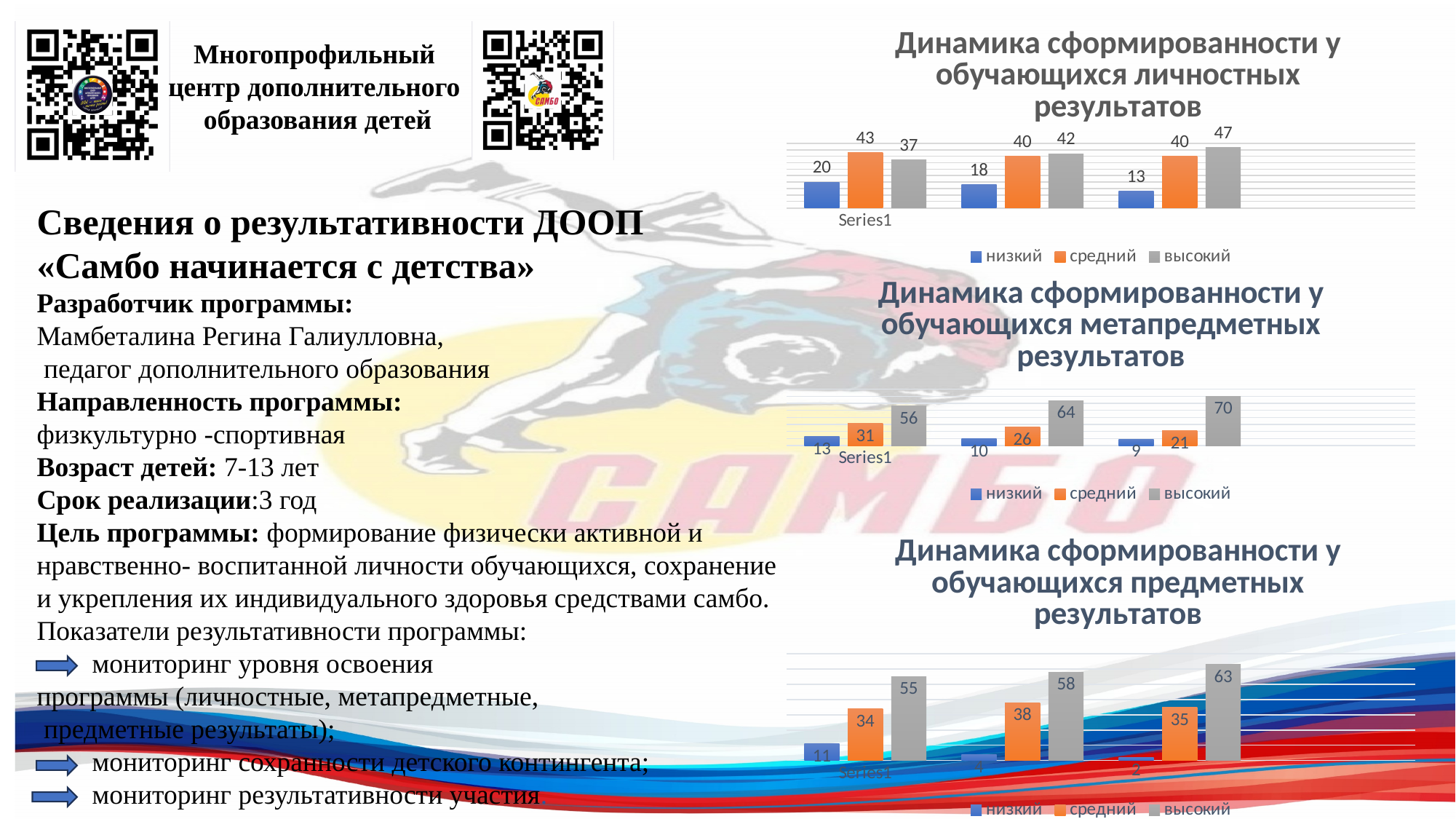
In the chart titled "Динамика сформированности у обучающихся личностных результатов", what is the value of the "низкий" bar in the first group (Series1)? 20 In the chart titled "Динамика сформированности у обучающихся предметных результатов", what is the value of the "средний" bar in the first group (Series1)? 34 What type of chart is the chart titled "Динамика сформированности у обучающихся личностных результатов"? bar chart In the chart titled "Динамика сформированности у обучающихся личностных результатов", what is the value of the "средний" bar in the first group (Series1)? 43 In the chart titled "Динамика сформированности у обучающихся личностных результатов", what is the highest value shown in the rightmost group of bars? 47 In the chart titled "Динамика сформированности у обучающихся предметных результатов", what is the value of the "высокий" bar in the rightmost group? 63 In the chart titled "Динамика сформированности у обучающихся личностных результатов", what is the difference between the "высокий" and "низкий" bars in the first group (Series1)? 17 In the chart titled "Динамика сформированности у обучающихся метапредметных результатов", do the "низкий" values rise or fall from the left group to the right group? fall In the chart titled "Динамика сформированности у обучающихся метапредметных результатов", what is the value of the "высокий" bar in the rightmost group? 70 How many series does the legend list in the chart titled "Динамика сформированности у обучающихся предметных результатов"? 3 In the chart titled "Динамика сформированности у обучающихся метапредметных результатов", which is larger in the first group (Series1): the "средний" bar or the "высокий" bar? высокий In the chart titled "Динамика сформированности у обучающихся метапредметных результатов", what is the value of the "высокий" bar in the first group (Series1)? 56